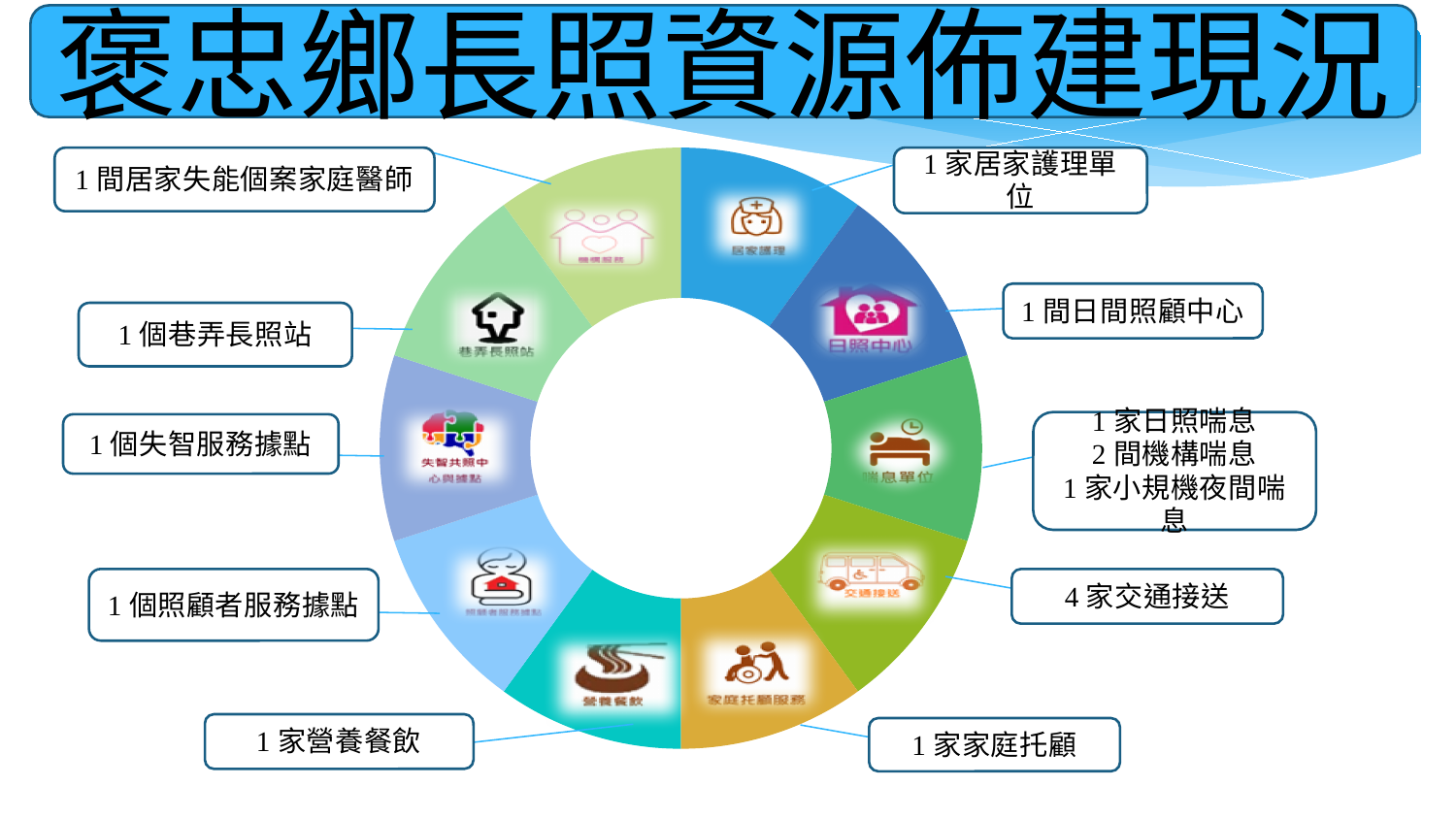
What is the total number of 喘息 resources listed in the 喘息單位 callout (1 家日照喘息, 2 間機構喘息, 1 家小規機夜間喘息)? 4 Which resource type has the highest number listed in its callout? 交通接送 What is the title of the slide's diagram? 褒忠鄉長照資源佈建現況 What kind of chart is shown on the slide? donut (ring) chart Which segment of the ring is labelled 居家護理? the blue segment at the top right How many 交通接送 providers are listed in the callout? 4 家 How many 巷弄長照站 are listed? 1 個 What is the difference between the number of 交通接送 (4) and the number of 營養餐飲 (1)? 3 How many 日間照顧中心 are listed? 1 間 How many 機構喘息 are listed in the 喘息單位 callout? 2 間 Which has more listed: 交通接送 or 家庭托顧? 交通接送 How many segments does the ring diagram have? 10